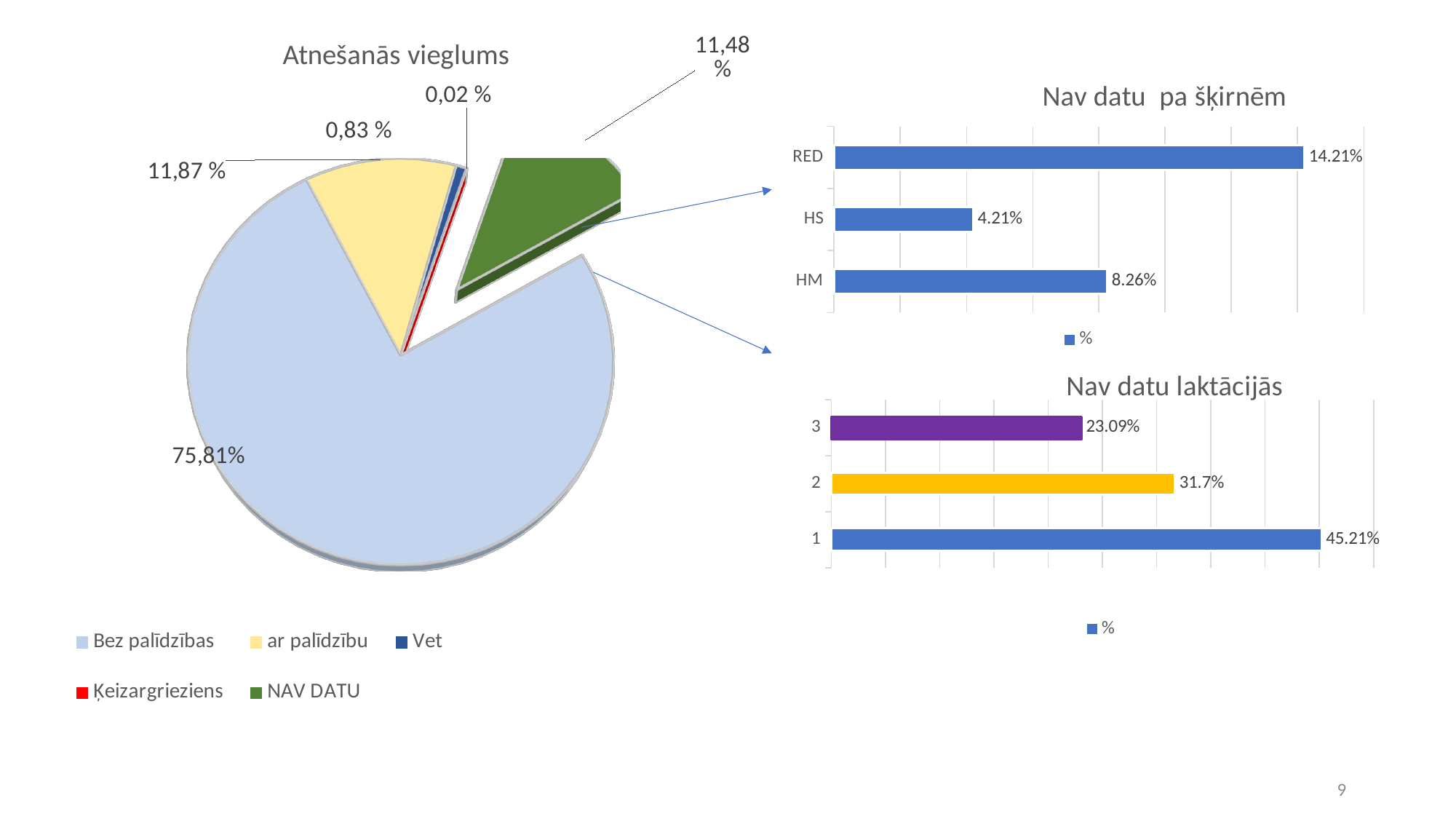
What kind of chart is 'Nav datu pa šķirnēm'? Bar chart In the pie chart 'Atnešanās vieglums', how many categories does the legend list? 5 In the pie chart 'Atnešanās vieglums', which category has the smallest slice? Ķeizargrieziens In the chart 'Nav datu pa šķirnēm', what is the difference between the values for RED and HM? 5.95% In the chart 'Nav datu laktācijās', what is the difference between the values for lactation 1 and lactation 3? 22.12% In the pie chart 'Atnešanās vieglums', what share is shown for 'NAV DATU'? 11,48 % In the pie chart 'Atnešanās vieglums', what share is shown for 'Bez palīdzības'? 75,81% In the chart 'Nav datu laktācijās', what is the value for lactation 2? 31.7% In the chart 'Nav datu laktācijās', which lactation has the highest value? 1 In the chart 'Nav datu pa šķirnēm', what is the value for RED? 14.21% In the pie chart 'Atnešanās vieglums', which is larger: 'ar palīdzību' or 'NAV DATU'? ar palīdzību In the chart 'Nav datu pa šķirnēm', which category has the lowest value? HS